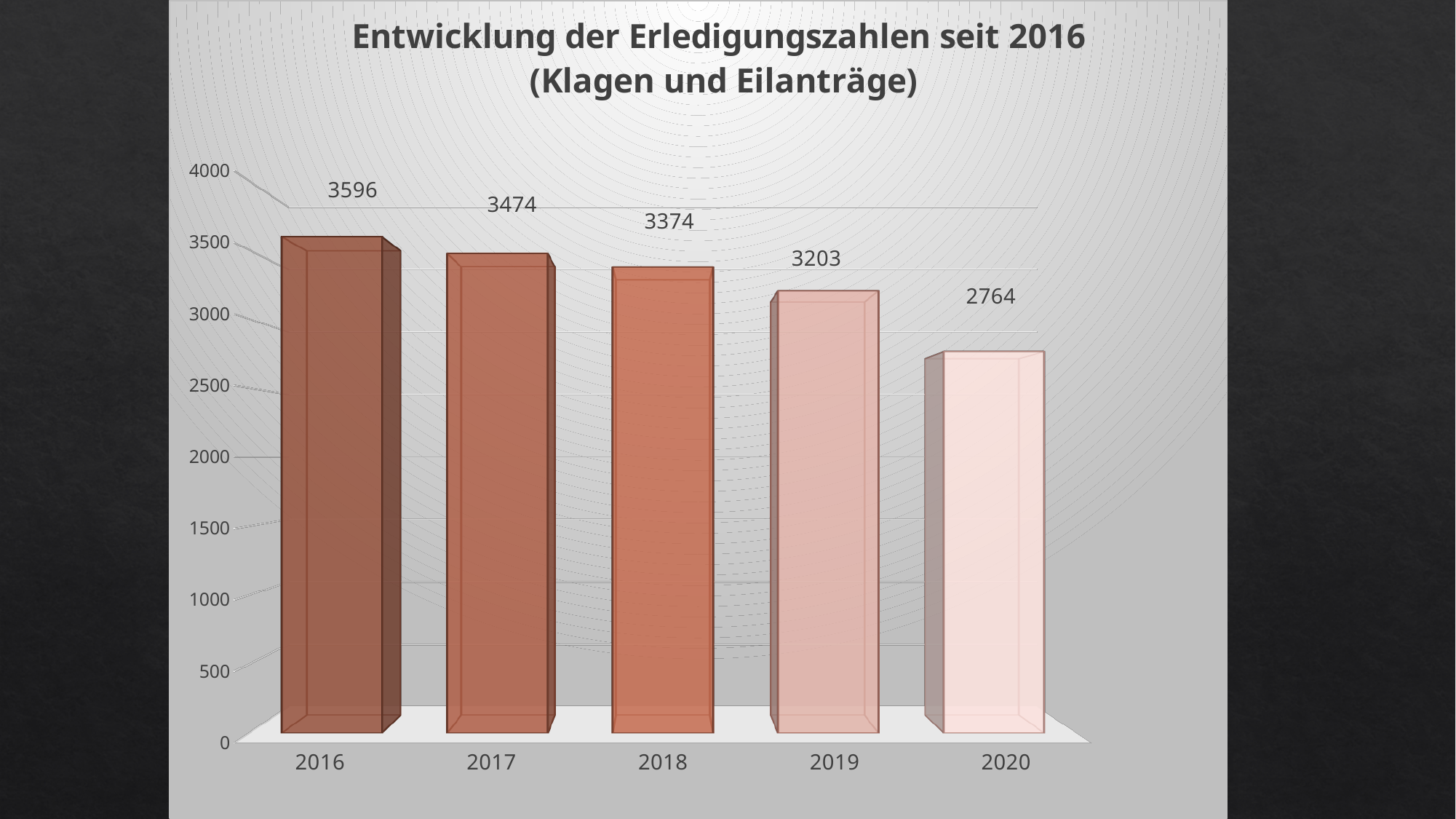
What is the value for 2020? 2764 What is the value for 2018? 3374 Which year has the highest value? 2016 Is the value for 2019 greater or less than 3000? greater Which is larger, the value for 2017 or the value for 2019? 2017 Do the values rise or fall from 2016 to 2020? fall What is the value for 2016? 3596 What is the difference between the values for 2018 and 2019? 171 How many years are shown on the x axis? 5 What kind of chart is shown? bar chart Which year has the lowest value? 2020 What is the difference between the values for 2016 and 2020? 832